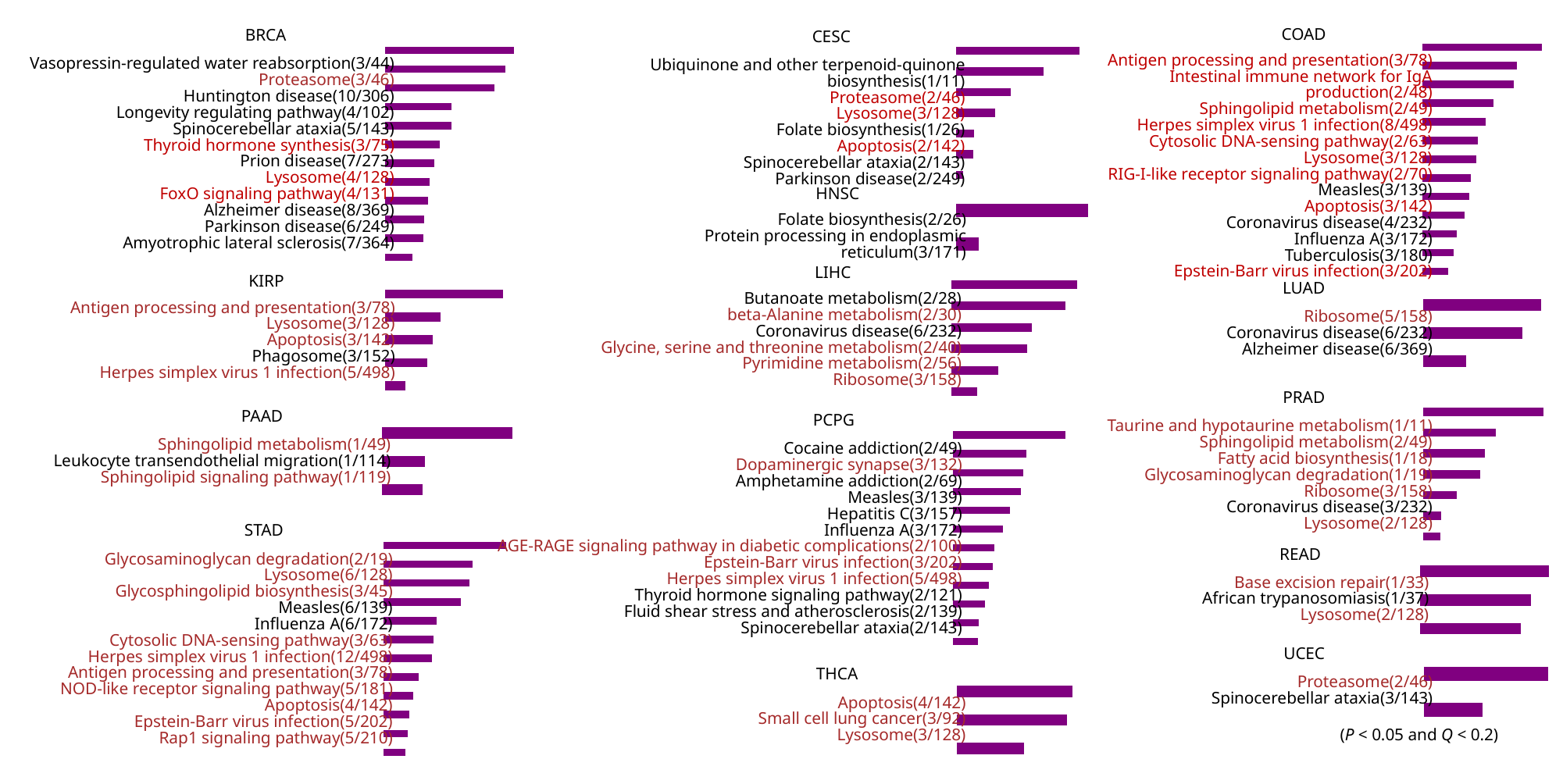
In the LIHC chart, which pathway has the longest bar? Butanoate metabolism(2/28) In the BRCA chart, which pathway has the shortest bar? Amyotrophic lateral sclerosis(7/364) How many pathways are listed in the BRCA chart? 12 In the BRCA chart, which pathway has the longest bar? Vasopressin-regulated water reabsorption(3/44) In the STAD chart, which pathway has the longest bar? Glycosaminoglycan degradation(2/19) What significance thresholds are stated in the note at the bottom right of the slide? P < 0.05 and Q < 0.2 In the THCA chart, which pathway has the shortest bar? Lysosome(3/128) In the BRCA chart, which bar is longer: Proteasome(3/46) or Huntington disease(10/306)? Proteasome(3/46) How many pathways are listed in the KIRP chart? 5 How many pathways are listed in the UCEC chart? 2 What kind of chart is used for the BRCA panel? bar chart